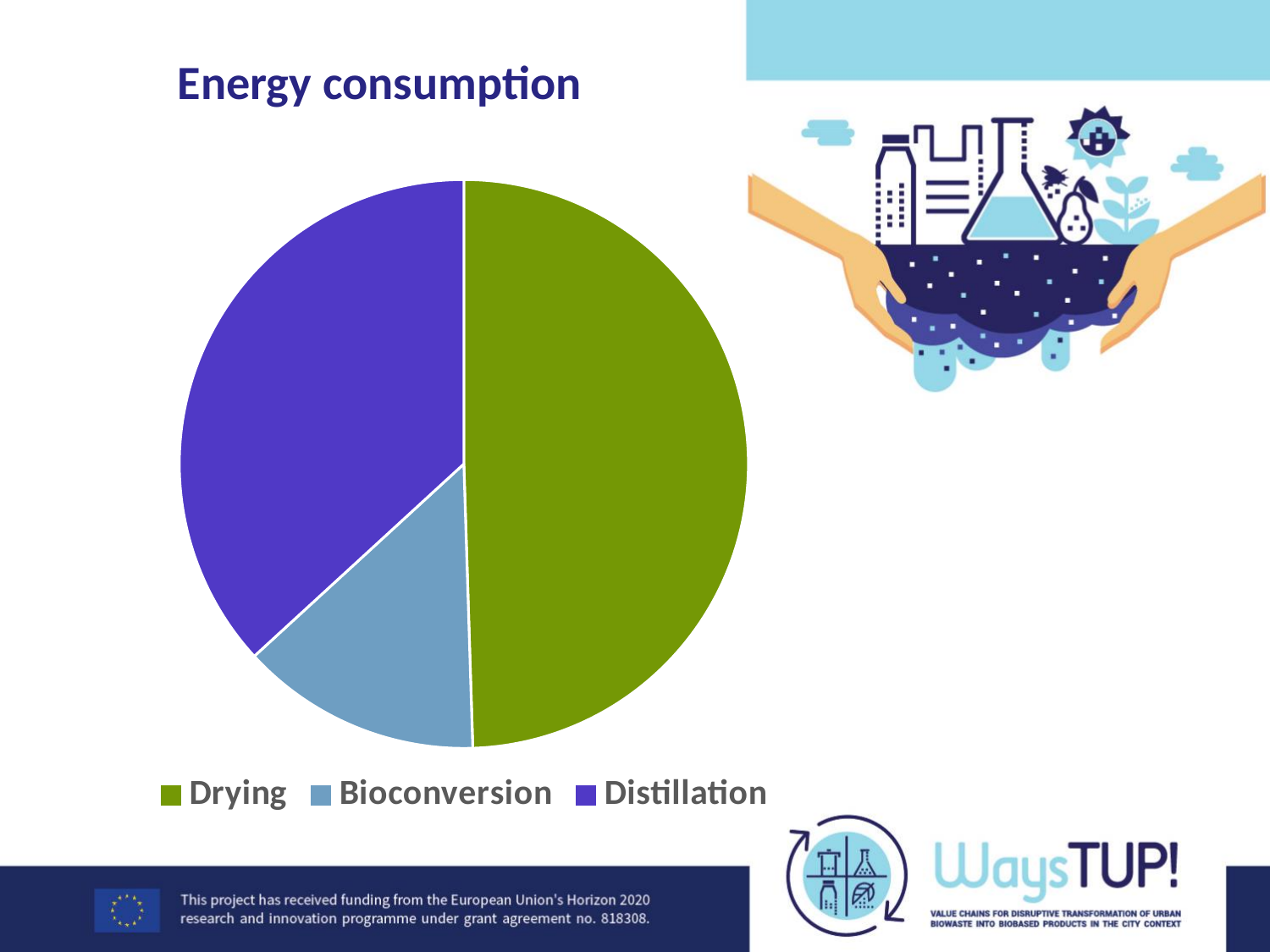
What is the title of the chart? Energy consumption Which category is shown in green in the pie chart? Drying What colour represents Distillation in the pie chart? purple Which has the larger share of energy consumption, Distillation or Bioconversion? Distillation How many slices does the pie chart have? 3 Which category accounts for the smallest share of energy consumption? Bioconversion Which has the smaller share of energy consumption, Drying or Bioconversion? Bioconversion How many entries does the legend list? 3 Which category accounts for the largest share of energy consumption? Drying What kind of chart is shown on the slide? pie chart Which has the larger share of energy consumption, Drying or Distillation? Drying